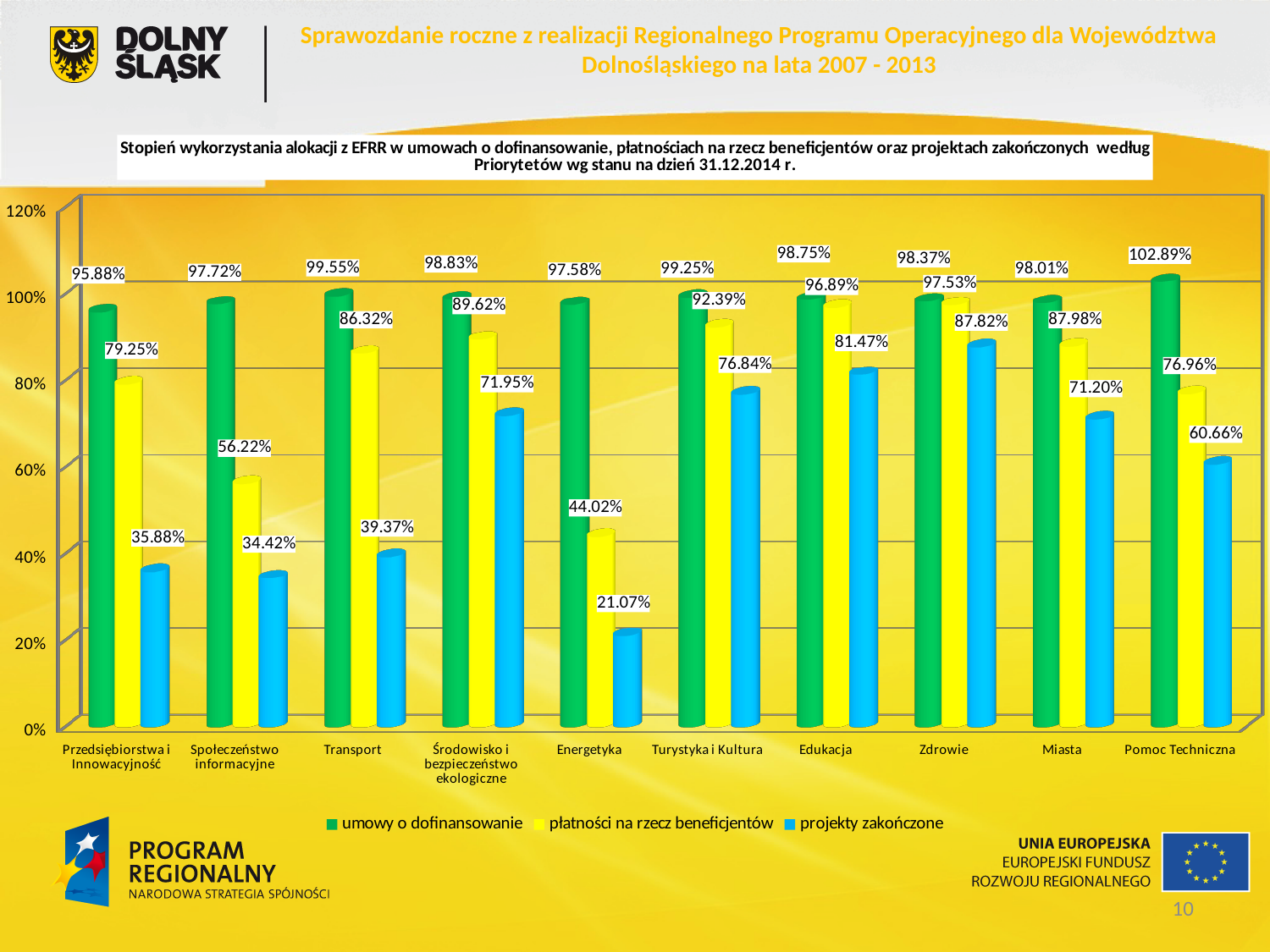
How many series does the legend list? 3 What kind of chart is shown on the slide? bar chart What is the value of 'umowy o dofinansowanie' for Transport? 99.55% What is the value of 'projekty zakończone' for Zdrowie? 87.82% Which category has the highest value for 'umowy o dofinansowanie'? Pomoc Techniczna How many categories are shown on the x axis? 10 Which is larger: 'projekty zakończone' for Miasta or for Pomoc Techniczna? Miasta What is the difference between 'umowy o dofinansowanie' and 'płatności na rzecz beneficjentów' for Edukacja? 1.86 percentage points Which colour represents 'projekty zakończone' in the legend? blue Which category has the lowest value for 'projekty zakończone'? Energetyka What is the value of 'płatności na rzecz beneficjentów' for Energetyka? 44.02% Is the value of 'płatności na rzecz beneficjentów' for Społeczeństwo informacyjne greater or less than 60%? less